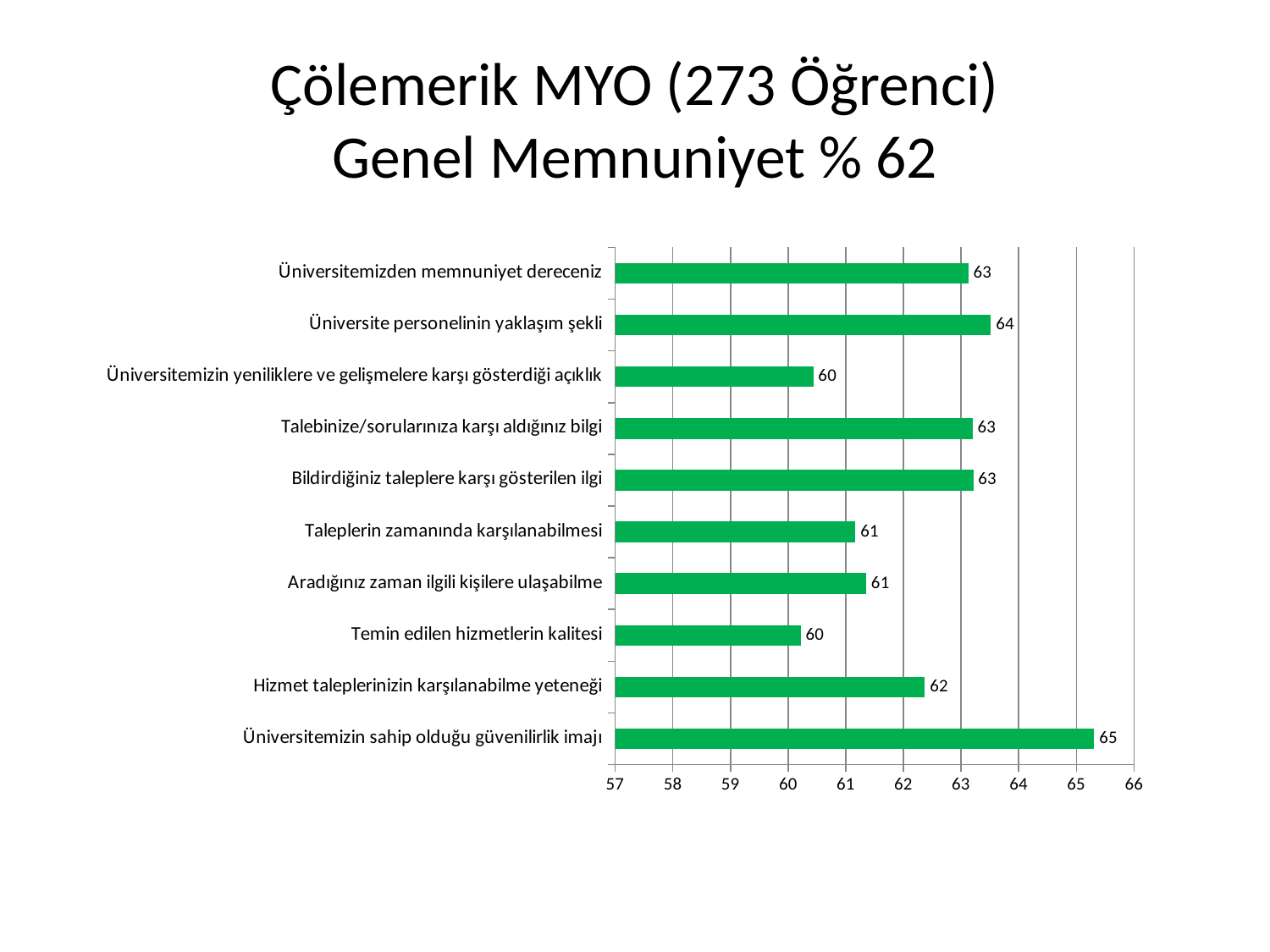
What is the value for "Üniversitemizin sahip olduğu güvenilirlik imajı"? 65 Is the value for "Üniversite personelinin yaklaşım şekli" greater or less than 62? greater Which category has the highest value? Üniversitemizin sahip olduğu güvenilirlik imajı What is the value for "Taleplerin zamanında karşılanabilmesi"? 61 What kind of chart is shown on the slide? bar chart What is the value for "Hizmet taleplerinizin karşılanabilme yeteneği"? 62 What is the difference between the values for "Üniversitemizin sahip olduğu güvenilirlik imajı" and "Temin edilen hizmetlerin kalitesi"? 5 What is the value for "Üniversite personelinin yaklaşım şekli"? 64 What is the title of the slide? Çölemerik MYO (273 Öğrenci) Genel Memnuniyet % 62 How many categories are shown in the chart? 10 Is the value for "Temin edilen hizmetlerin kalitesi" greater or less than 62? less Which is larger: the value for "Üniversite personelinin yaklaşım şekli" or the value for "Üniversitemizin yeniliklere ve gelişmelere karşı gösterdiği açıklık"? Üniversite personelinin yaklaşım şekli